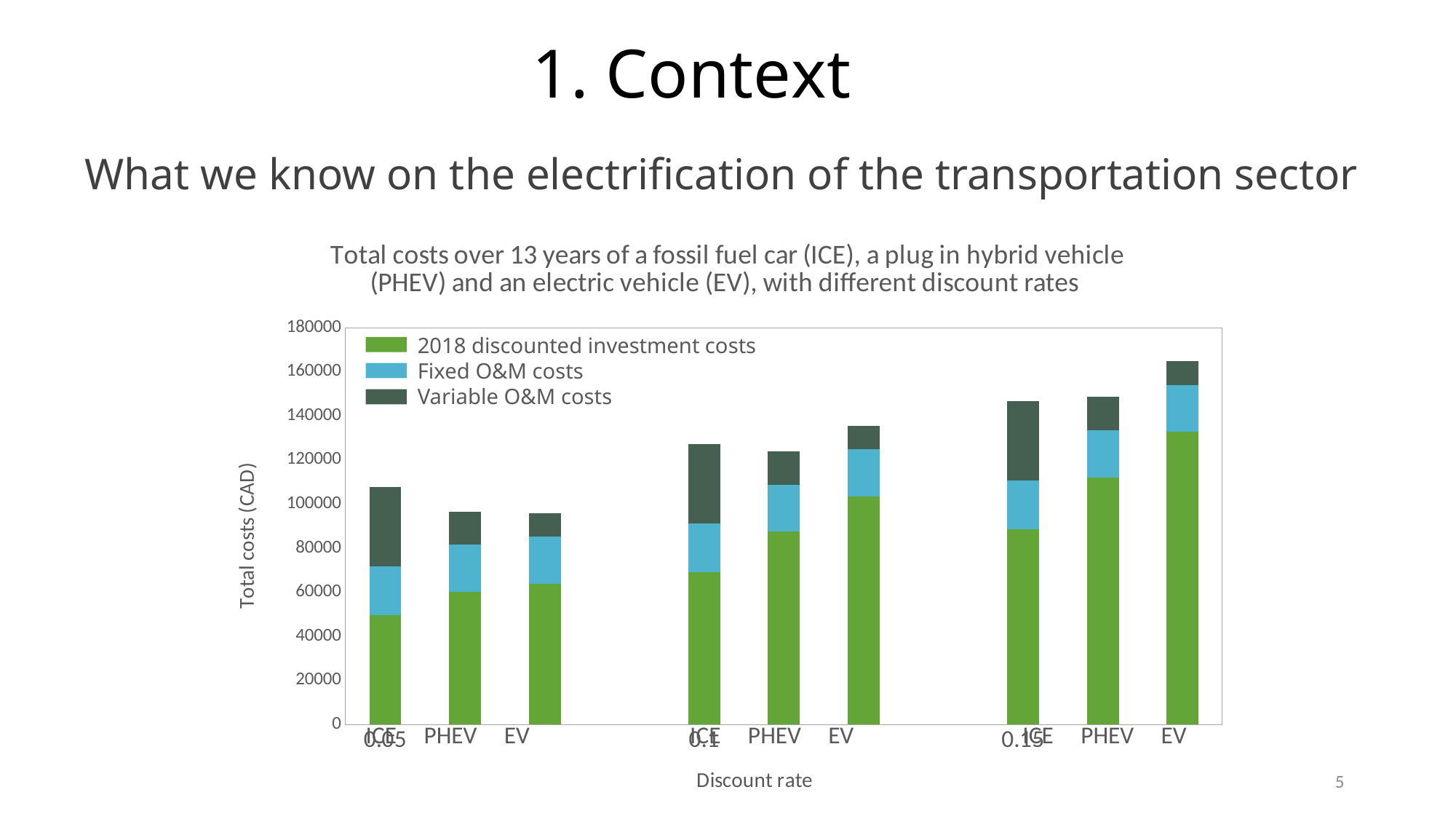
How many series does the legend list? 3 What kind of chart is shown on the slide? Stacked bar chart Is the total cost for PHEV at a discount rate of 0.05 greater or less than 100000? less Which vehicle type has the highest total cost bar at a discount rate of 0.05? ICE How does the total cost for EV change as the discount rate increases from 0.05 to 0.15? It rises Which series are listed in the legend? 2018 discounted investment costs, Fixed O&M costs, Variable O&M costs At a discount rate of 0.1, which has the larger total cost, ICE or EV? EV Is the total cost for EV at a discount rate of 0.15 greater or less than 140000? greater What is the title of the y axis? Total costs (CAD) How many bars are plotted in the chart? 9 Which vehicle type has the highest total cost bar at a discount rate of 0.15? EV Is the total cost for ICE at a discount rate of 0.05 greater or less than 100000? greater